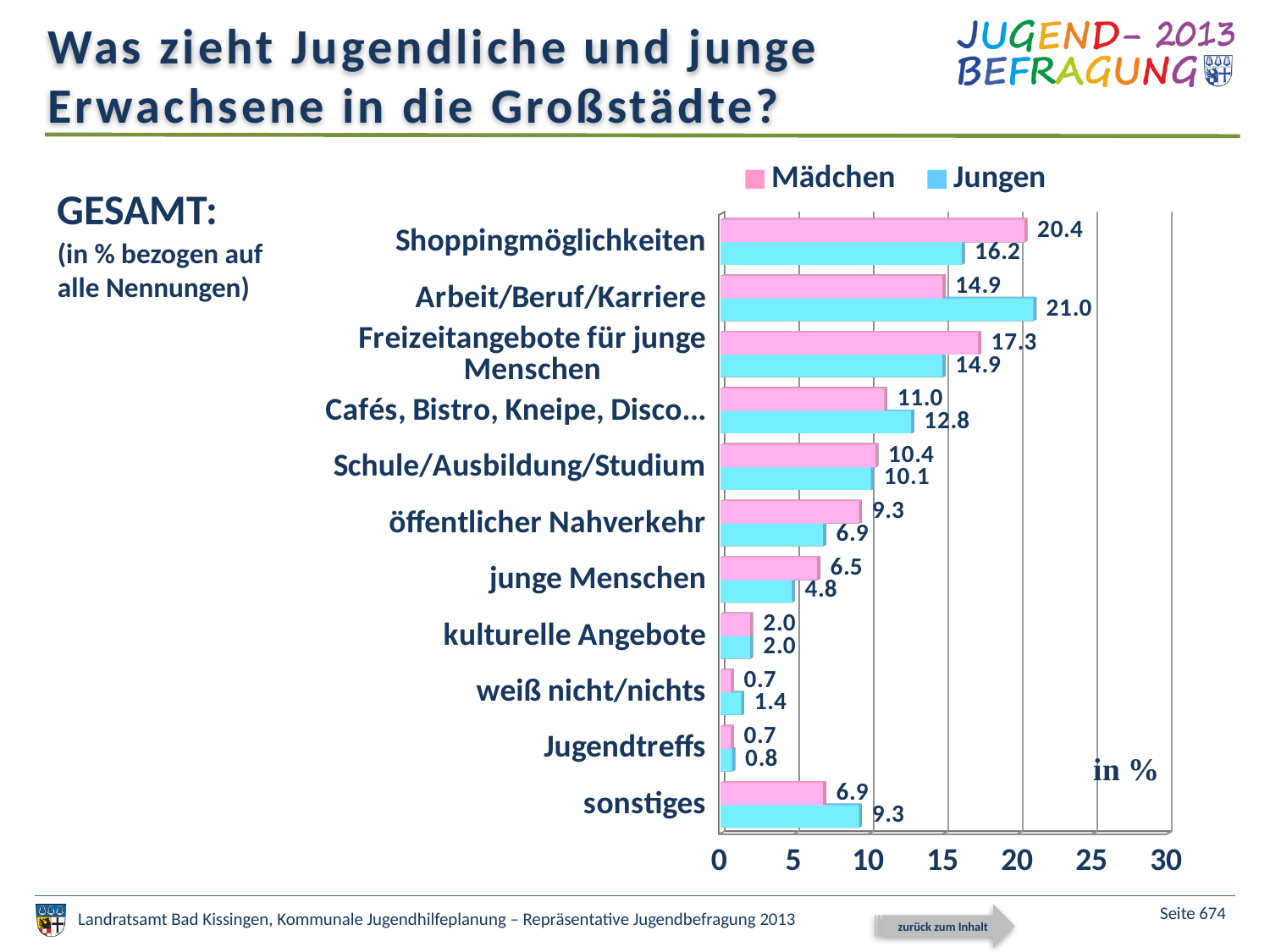
Which category has the highest value for Jungen? Arbeit/Beruf/Karriere What kind of chart is shown on the slide? Bar chart How many categories are shown in the chart? 11 Which category has the lowest value for Jungen? Jugendtreffs What is the value for Mädchen for Freizeitangebote für junge Menschen? 17.3 Which category has the highest value for Mädchen? Shoppingmöglichkeiten What is the value for Jungen for Arbeit/Beruf/Karriere? 21.0 What is the value for Jungen for öffentlicher Nahverkehr? 6.9 Which is larger for Cafés, Bistro, Kneipe, Disco..., the Mädchen value or the Jungen value? Jungen What is the value for Mädchen for Shoppingmöglichkeiten? 20.4 What is the difference between the Jungen and Mädchen values for Arbeit/Beruf/Karriere? 6.1 How many series does the legend list? 2